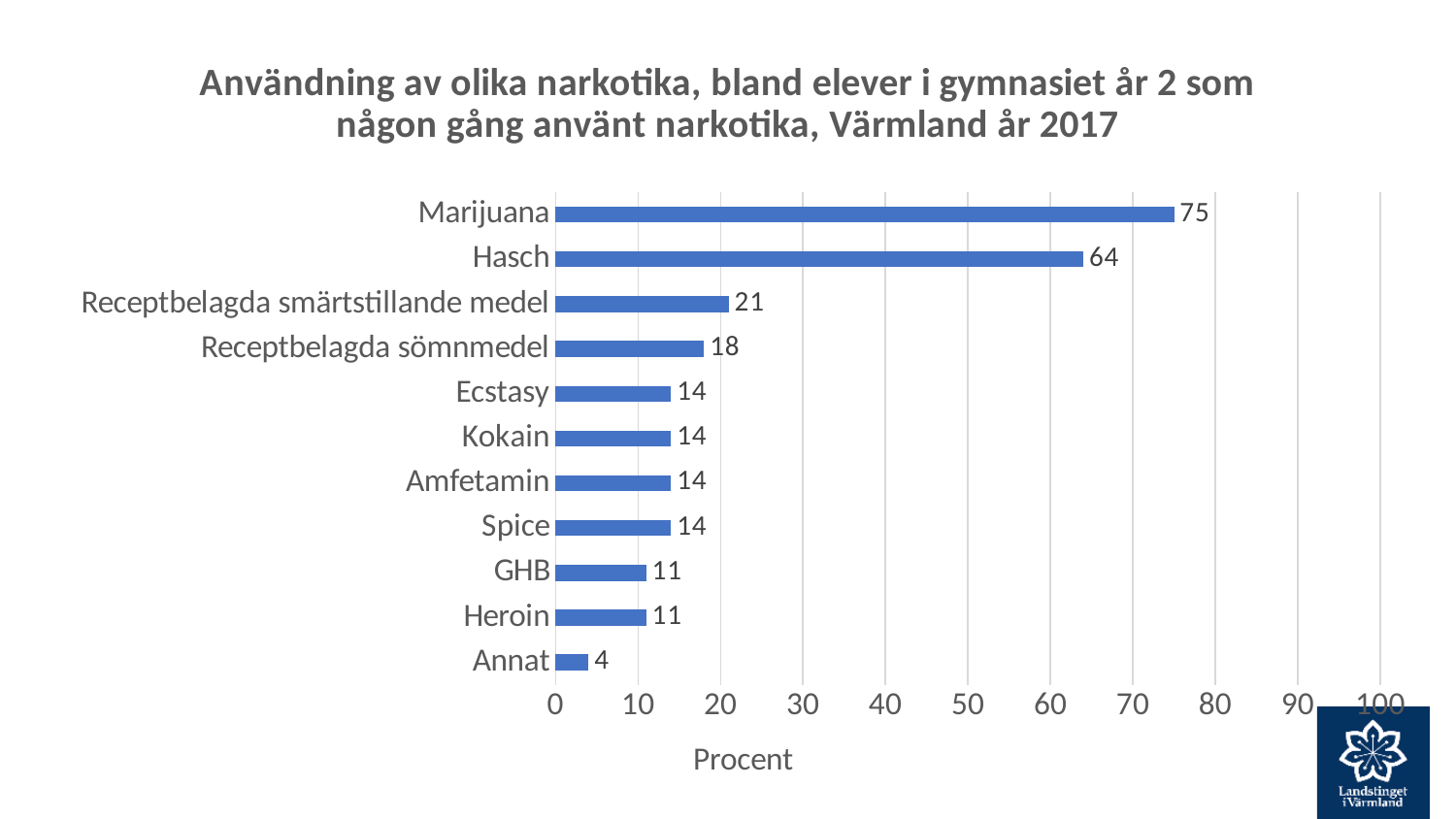
Which category has the lowest value? Annat How many categories are shown in the chart? 11 Which is larger, the value for Receptbelagda smärtstillande medel or the value for GHB? Receptbelagda smärtstillande medel Which category has the highest value? Marijuana Is the value for Hasch greater or less than 50? greater What kind of chart is shown on the slide? Bar chart What is the difference between the values for Marijuana and Hasch? 11 What is the value for Receptbelagda sömnmedel? 18 What is the difference between the values for Ecstasy and Heroin? 3 What is the value for Annat? 4 What is the value for Marijuana? 75 What is the label of the horizontal axis? Procent